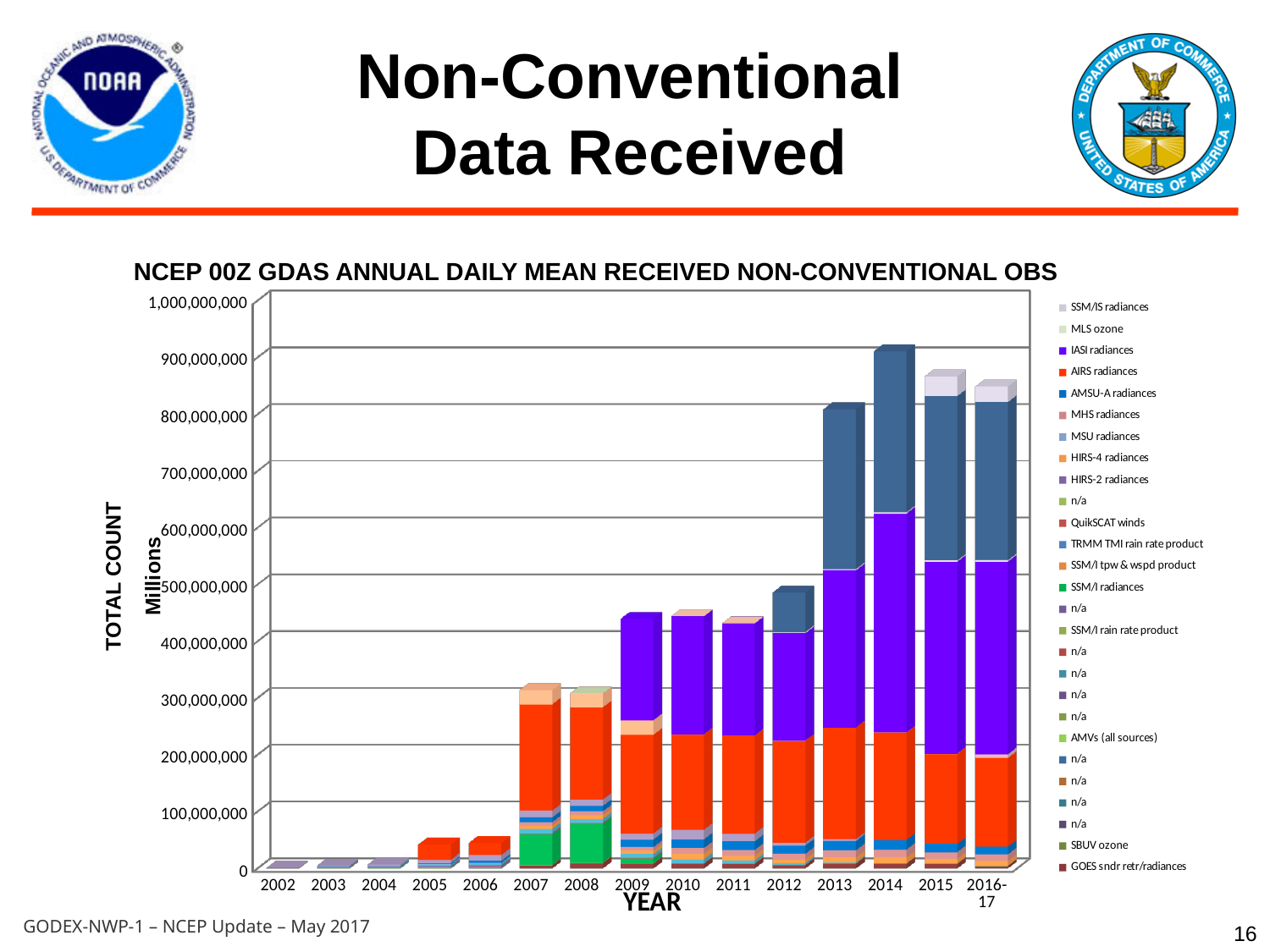
What is the title of the chart? NCEP 00Z GDAS ANNUAL DAILY MEAN RECEIVED NON-CONVENTIONAL OBS Is the total value for 2009 greater or less than 400,000,000? greater Is the total value for 2005 greater or less than 100,000,000? less What kind of chart is shown on the slide? Stacked bar chart How many year categories are shown on the x axis of the chart? 15 Which year has the larger total bar, 2014 or 2015? 2014 Which year has the lowest total bar in the chart? 2002 Is the total value for 2012 greater or less than 500,000,000? less Do the total bar heights generally rise or fall from 2002 to 2014? rise Which year has the highest total bar in the chart? 2014